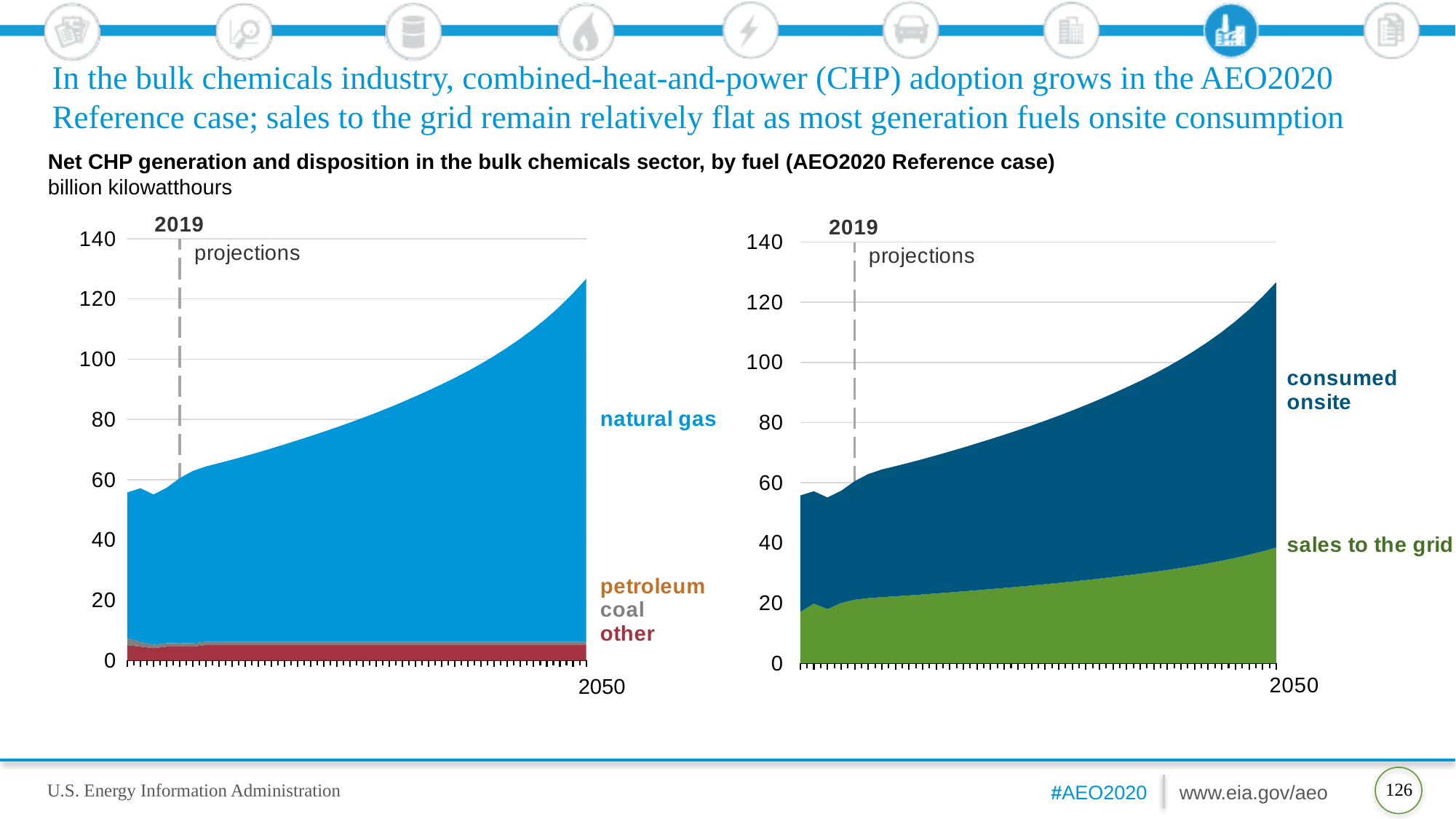
What year does the dashed vertical line in each chart mark as the start of projections? 2019 In the left chart (by fuel), is the total net CHP generation in 2050 greater or less than 120? greater How many series does the right chart (consumed onsite / sales to the grid) show? 2 In the left chart (by fuel), does total net CHP generation rise or fall from 2019 to 2050? rises What unit is used for the values in both charts? billion kilowatthours In the right chart, is the total net CHP generation in 2019 greater or less than 80? less How many series does the left chart (by fuel) show? 4 In the right chart, do sales to the grid rise or fall over the projection period to 2050? rises In the right chart, is the value for sales to the grid in 2050 greater or less than 20? greater What kind of chart is the left chart (by fuel)? area chart In the right chart, which disposition is larger in 2050, consumed onsite or sales to the grid? consumed onsite In the left chart (by fuel), which fuel accounts for the largest share of net CHP generation? natural gas